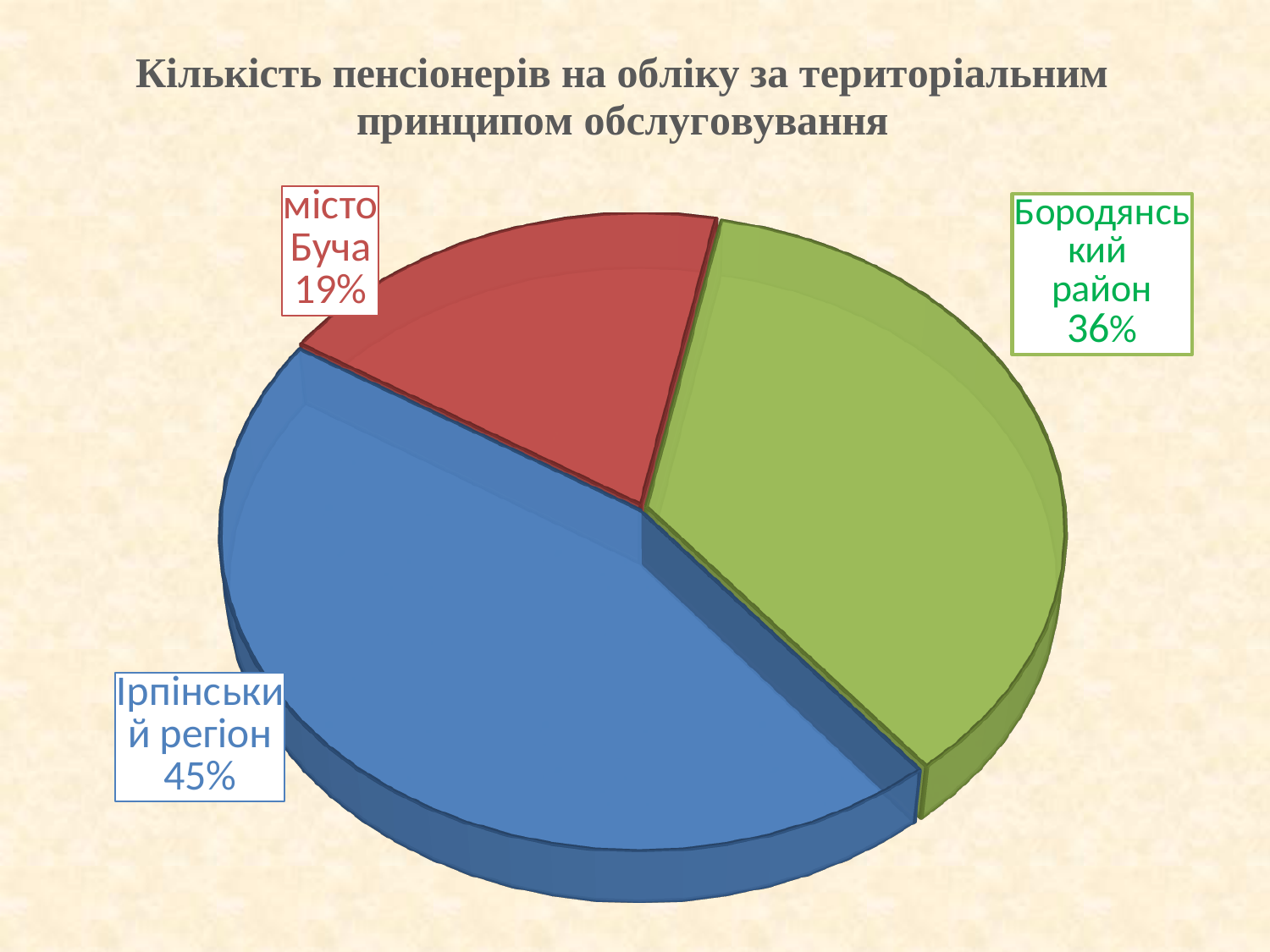
What share of the pie does Бородянський район have? 36% Which category has the largest share of the pie? Ірпінський регіон What share of the pie does місто Буча have? 19% What kind of chart is shown on the slide? pie chart How many slices does the pie chart have? 3 What is the title of the chart? Кількість пенсіонерів на обліку за територіальним принципом обслуговування What share of the pie does Ірпінський регіон have? 45% Which category has the smallest share of the pie? місто Буча Which is larger, the share for Бородянський район or the share for місто Буча? Бородянський район What colour is the slice for Ірпінський регіон? blue What is the difference in percentage points between Ірпінський регіон and Бородянський район? 9 What is the difference in percentage points between Бородянський район and місто Буча? 17